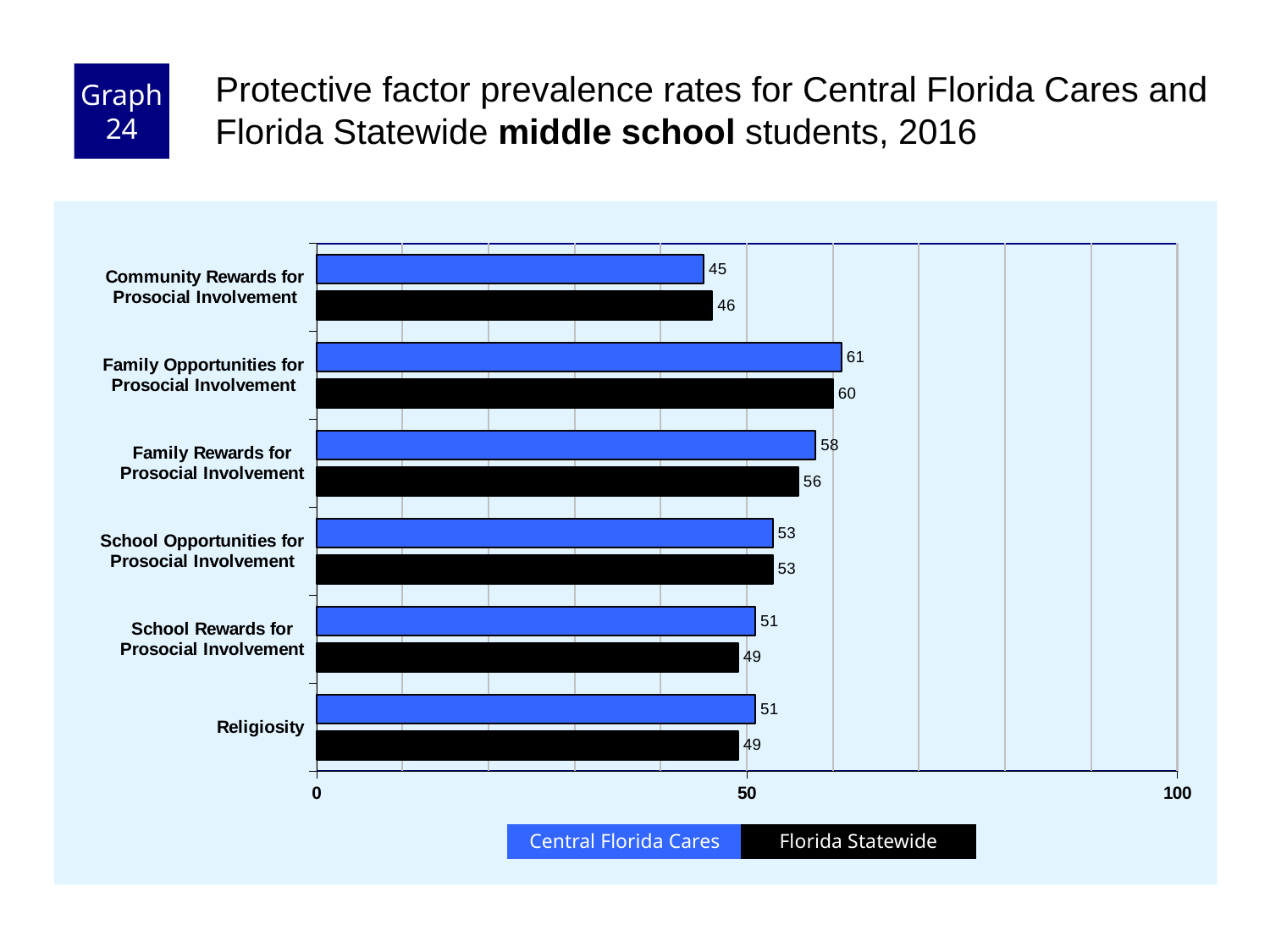
How many series does the legend list? 2 What is the difference between the Central Florida Cares and Florida Statewide values for Family Rewards for Prosocial Involvement? 2 Which category has the lowest Florida Statewide value? Community Rewards for Prosocial Involvement How many protective factor categories are shown on the chart? 6 Is the Central Florida Cares value for Community Rewards for Prosocial Involvement greater or less than 50? less What kind of chart is shown on the slide? bar chart Which colour represents Florida Statewide in the chart? black Which category has the highest Central Florida Cares value? Family Opportunities for Prosocial Involvement What is the Florida Statewide value for Community Rewards for Prosocial Involvement? 46 What is the Central Florida Cares value for Family Opportunities for Prosocial Involvement? 61 What is the Florida Statewide value for Religiosity? 49 For School Rewards for Prosocial Involvement, which is larger: the Central Florida Cares value or the Florida Statewide value? Central Florida Cares